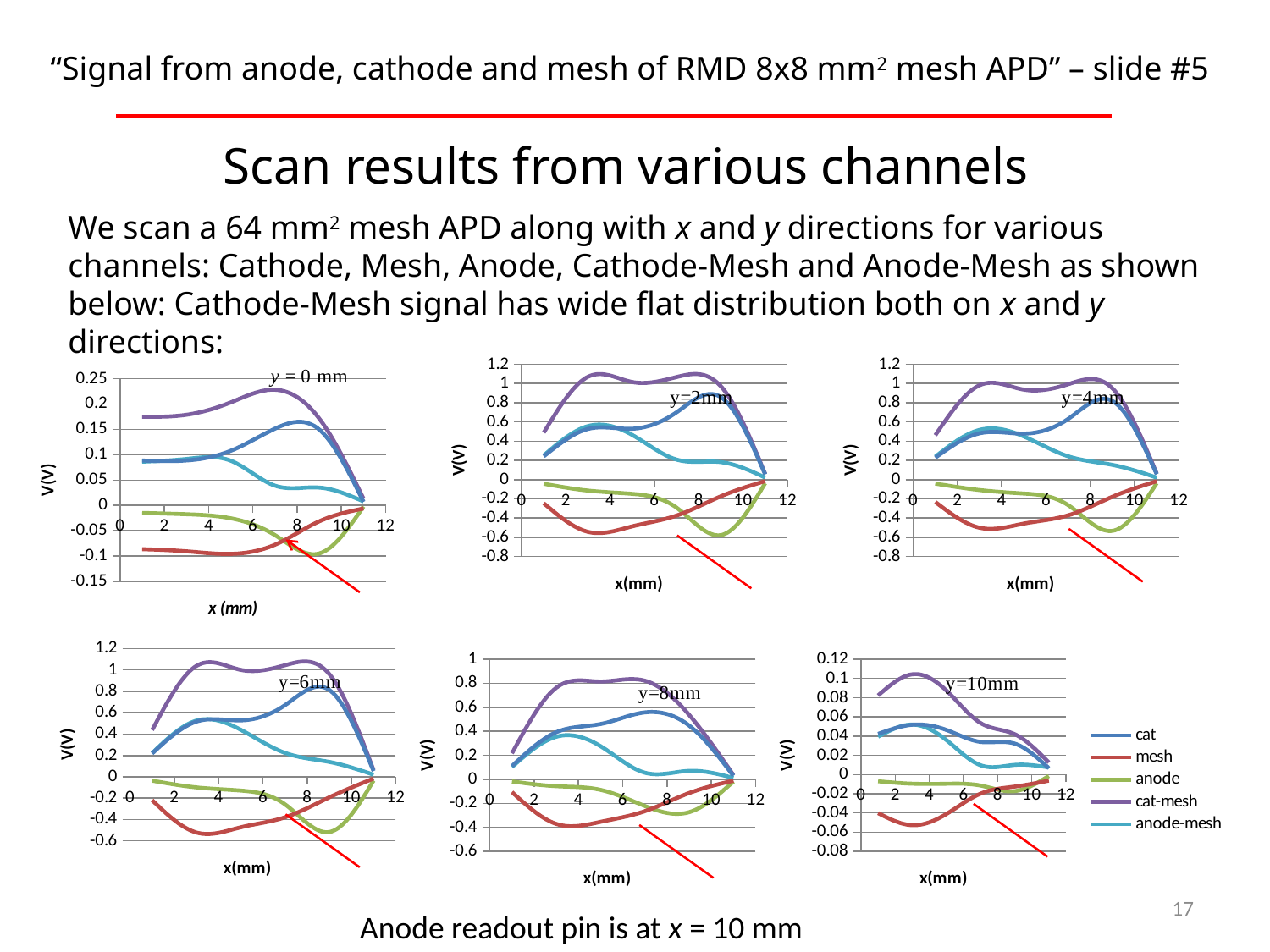
What is the highest tick value on the vertical axis of the y=2mm chart? 1.2 In the y=8mm chart, is the mesh value at x = 4 greater or less than -0.2? less In the y = 0 mm chart, which series has the highest values across the scan? cat-mesh How many scan charts are shown on the slide? 6 What is the label on the vertical axis of the charts? V(V) What kind of chart is used for the y = 0 mm panel? line chart In the y = 0 mm chart, is the cat-mesh value at x = 2 greater or less than 0.1? greater In the y=4mm chart, is the anode-mesh value at x = 8 greater or less than 0.4? less In the y=6mm chart, at x = 2, which is larger: cat-mesh or cat? cat-mesh How many series does the legend on the right list? 5